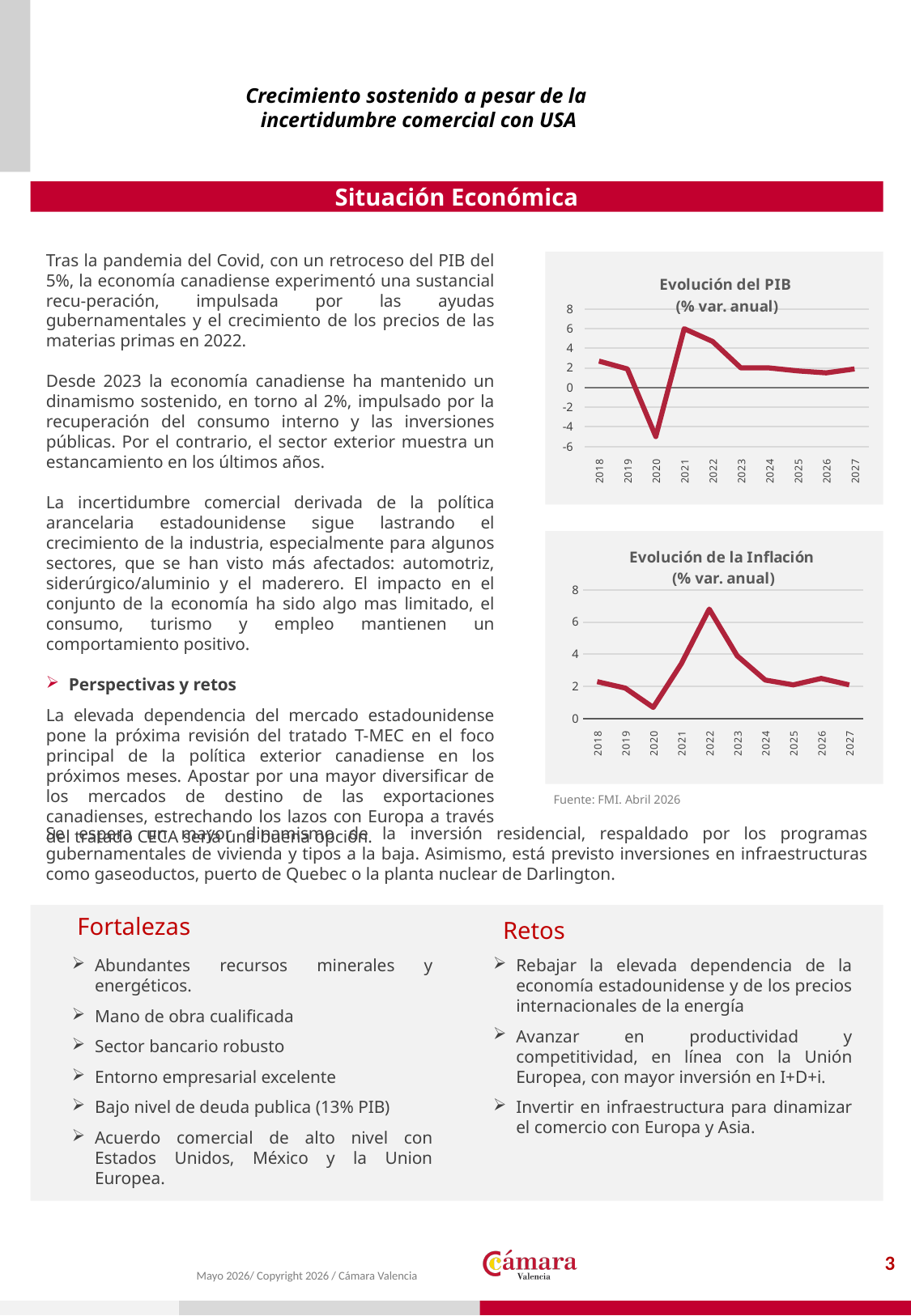
In the 'Evolución de la Inflación' chart, which is larger, the value for 2021 or the value for 2023? 2023 What source is cited below the charts? FMI. Abril 2026 In the 'Evolución del PIB' chart, is the value for 2021 greater or less than 4? greater In the 'Evolución del PIB' chart, is the value for 2020 greater or less than -4? less In the 'Evolución del PIB' chart, which year has the lowest value? 2020 In the 'Evolución de la Inflación' chart, which year has the highest value? 2022 In the 'Evolución del PIB' chart, which year has the highest value? 2021 How many years are plotted on the x axis of the 'Evolución del PIB' chart? 10 In the 'Evolución de la Inflación' chart, do the values rise or fall from 2022 to 2025? fall What kind of chart is the 'Evolución del PIB' chart? line chart In the 'Evolución de la Inflación' chart, is the value for 2022 greater or less than 6? greater In the 'Evolución de la Inflación' chart, which year has the lowest value? 2020